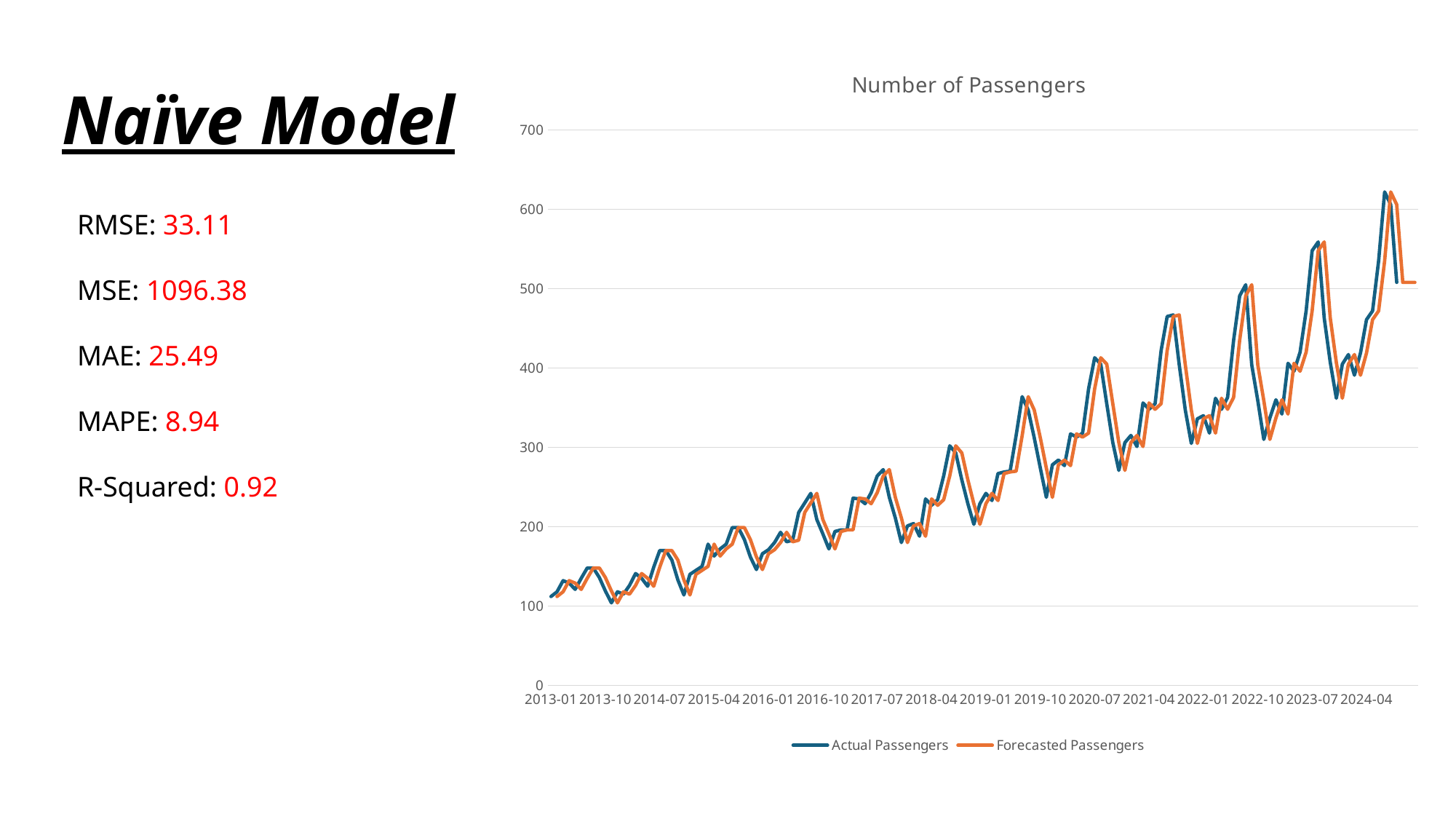
Is the highest value of the Forecasted Passengers line greater or less than 500? greater What kind of chart is shown on the slide? line chart How many series does the chart's legend list? 2 Is the value of Actual Passengers at 2013-01 greater or less than 200? less Is the peak of the Actual Passengers line in 2024 greater or less than the peak in 2023-07? greater Is the highest value of the Actual Passengers line greater or less than 600? greater What is the title of the chart? Number of Passengers What are the two series named in the chart's legend? Actual Passengers and Forecasted Passengers What is the highest value shown on the chart's vertical axis? 700 Do the passenger values generally rise or fall from 2013-01 to 2024-04? rise